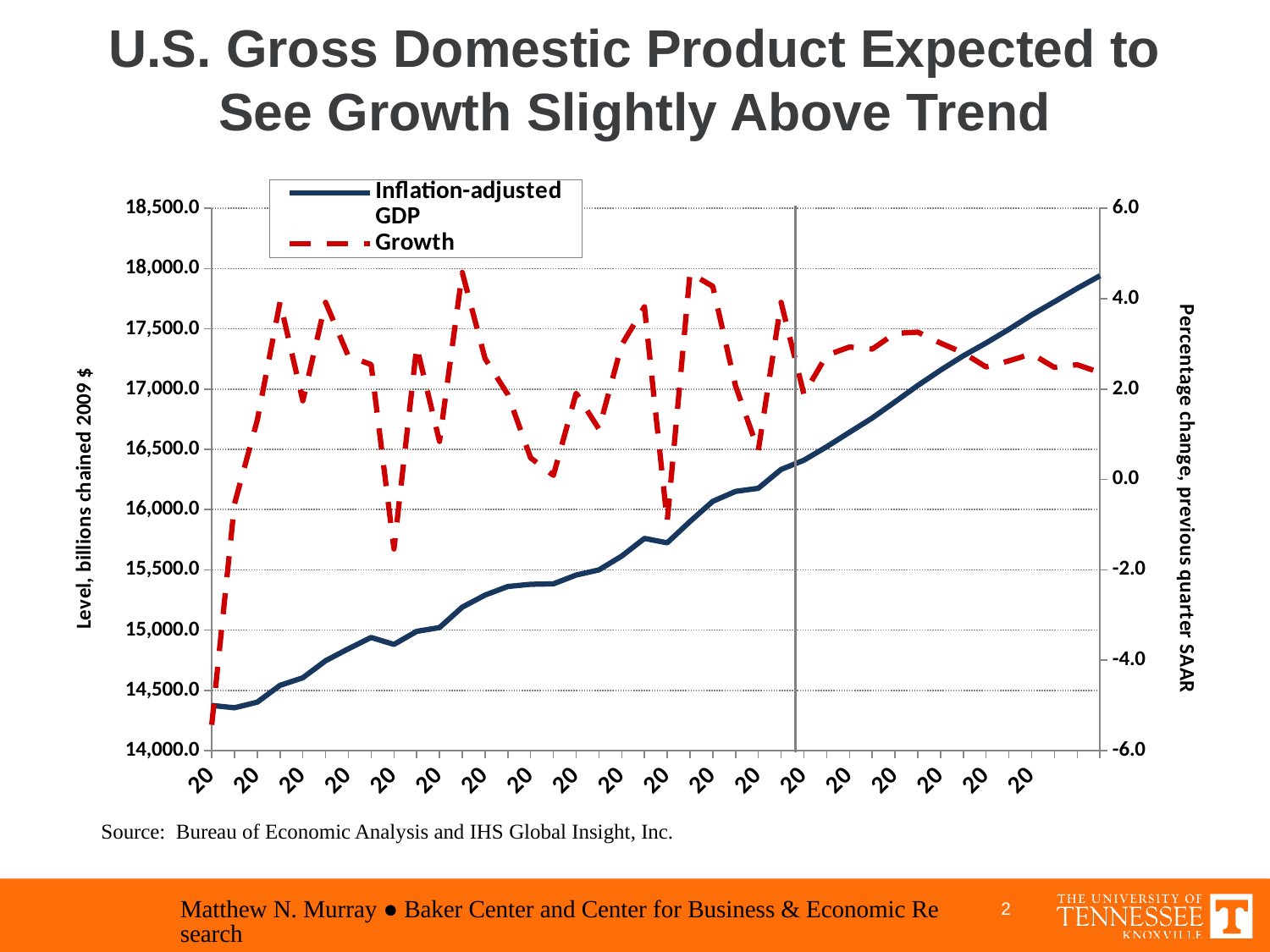
Is the value of Inflation-adjusted GDP at the vertical divider line greater or less than 16,000.0? greater Is the lowest value of the Growth series greater or less than -4.0? less How many series does the legend list? 2 Is the value of Inflation-adjusted GDP at the leftmost point greater or less than 14,500.0? less What are the two series named in the legend? Inflation-adjusted GDP and Growth What is the highest tick value shown on the left vertical axis? 18,500.0 Which series is drawn as a dashed red line? Growth What kind of chart is shown on the slide? Line chart Does the Inflation-adjusted GDP line generally rise or fall from left to right? Rise